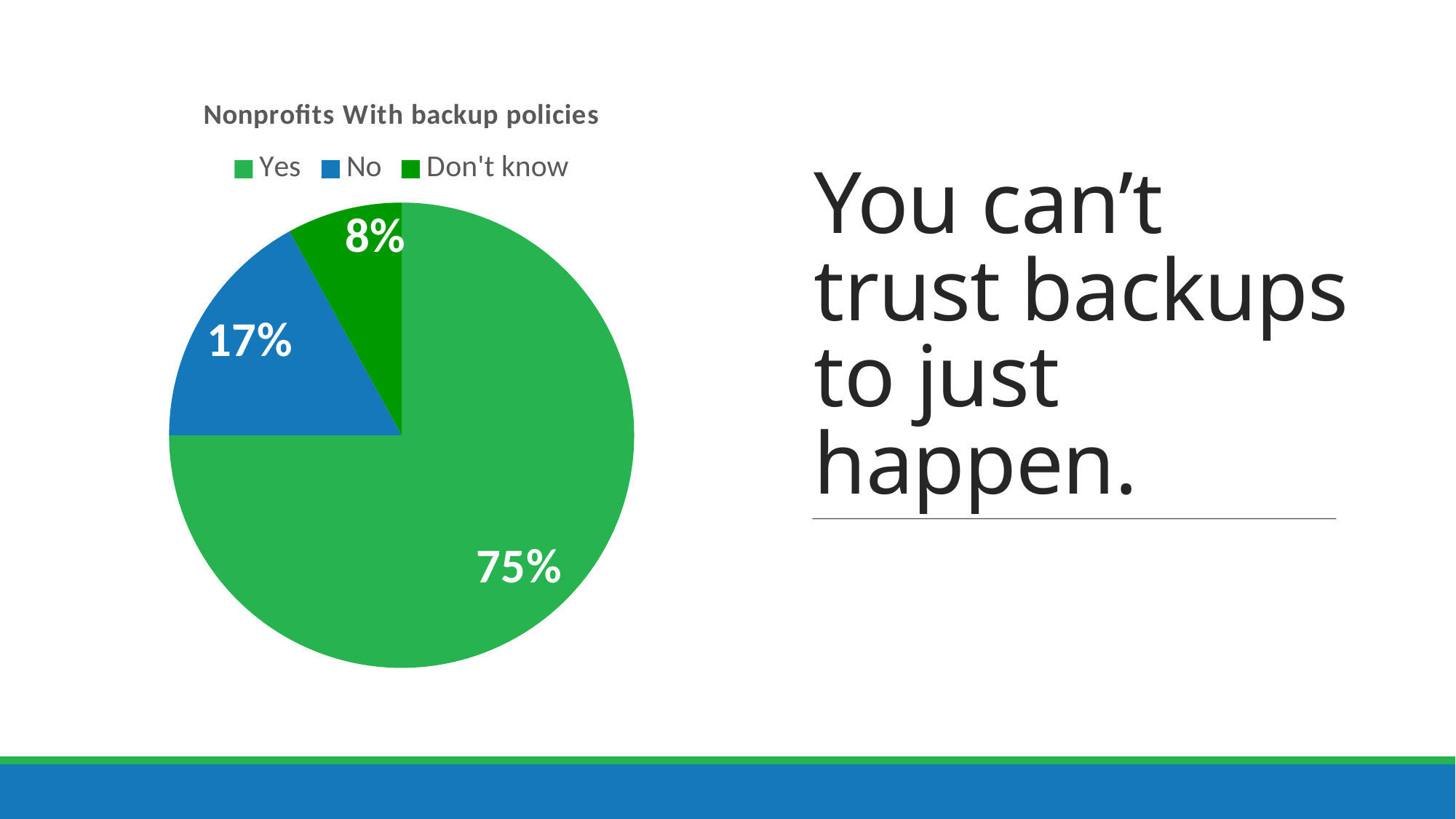
What is the difference in percentage points between the "Yes" and "No" slices? 58 What kind of chart is shown on the slide? Pie chart How many categories are shown in the pie chart? 3 What colour is the "No" slice in the pie chart? Blue Which category has the smallest slice of the pie? Don't know Which category has the largest slice of the pie? Yes What percentage of nonprofits answered "Don't know"? 8% What percentage of nonprofits answered "No" to having backup policies? 17% What is the title of the chart? Nonprofits With backup policies Which is larger, the "No" slice or the "Don't know" slice? No What percentage of nonprofits answered "Yes" to having backup policies? 75% What is the difference in percentage points between the "No" and "Don't know" slices? 9